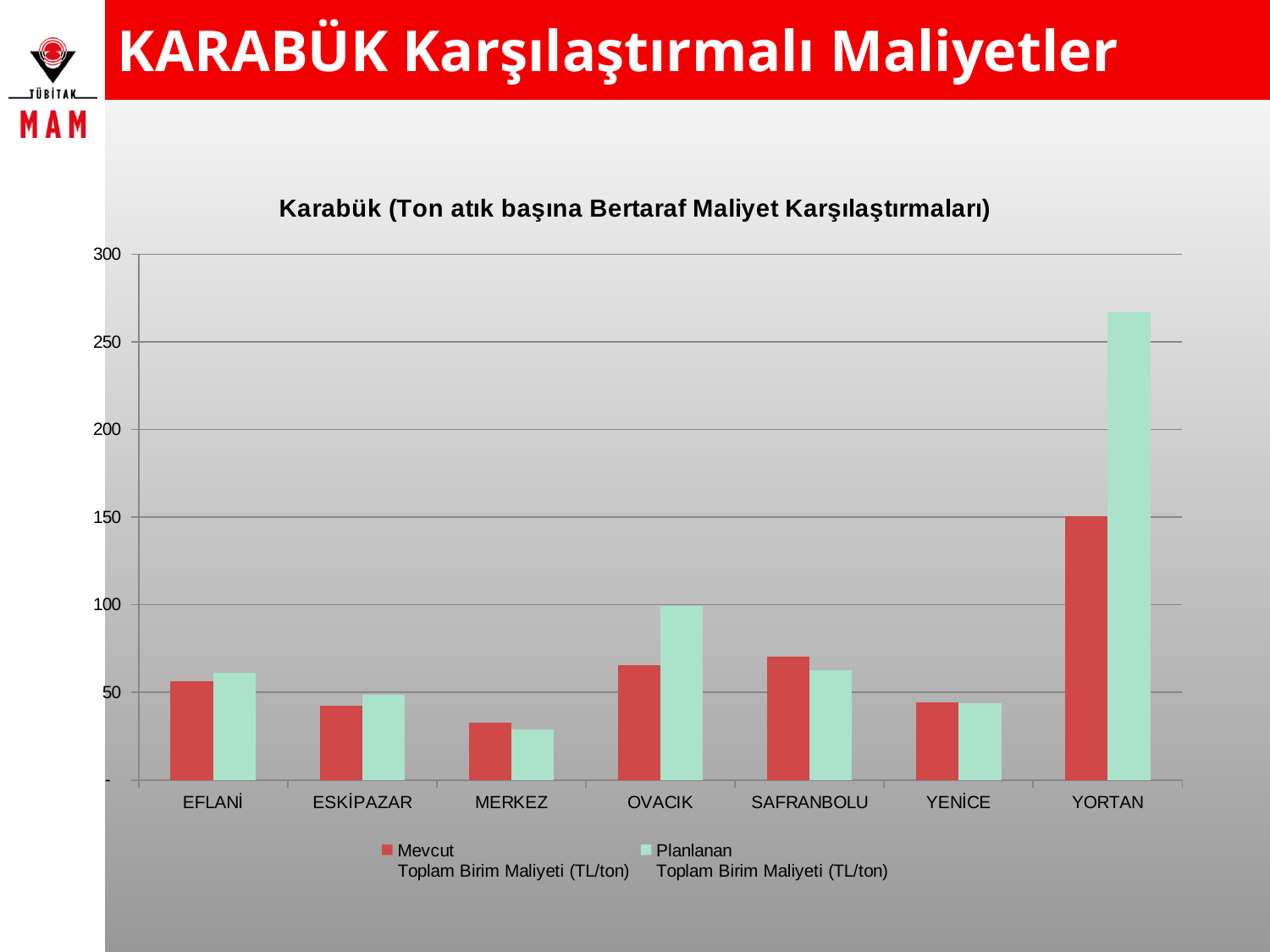
Which category has the highest Mevcut Toplam Birim Maliyeti (TL/ton) value? YORTAN Is the Mevcut Toplam Birim Maliyeti value for YORTAN greater or less than 100? greater What kind of chart is shown on the slide? Bar chart How many series does the chart's legend list? 2 Which category has the highest Planlanan Toplam Birim Maliyeti (TL/ton) value? YORTAN Is the Mevcut Toplam Birim Maliyeti value for MERKEZ greater or less than 50? less For OVACIK, which is larger: the Mevcut or the Planlanan Toplam Birim Maliyeti? Planlanan How many categories (districts) are shown on the x axis of the chart? 7 What is the title of the chart? Karabük (Ton atık başına Bertaraf Maliyet Karşılaştırmaları) Which category has the lowest Planlanan Toplam Birim Maliyeti (TL/ton) value? MERKEZ Which category has the lowest Mevcut Toplam Birim Maliyeti (TL/ton) value? MERKEZ Is the Planlanan Toplam Birim Maliyeti value for YORTAN greater or less than 250? greater